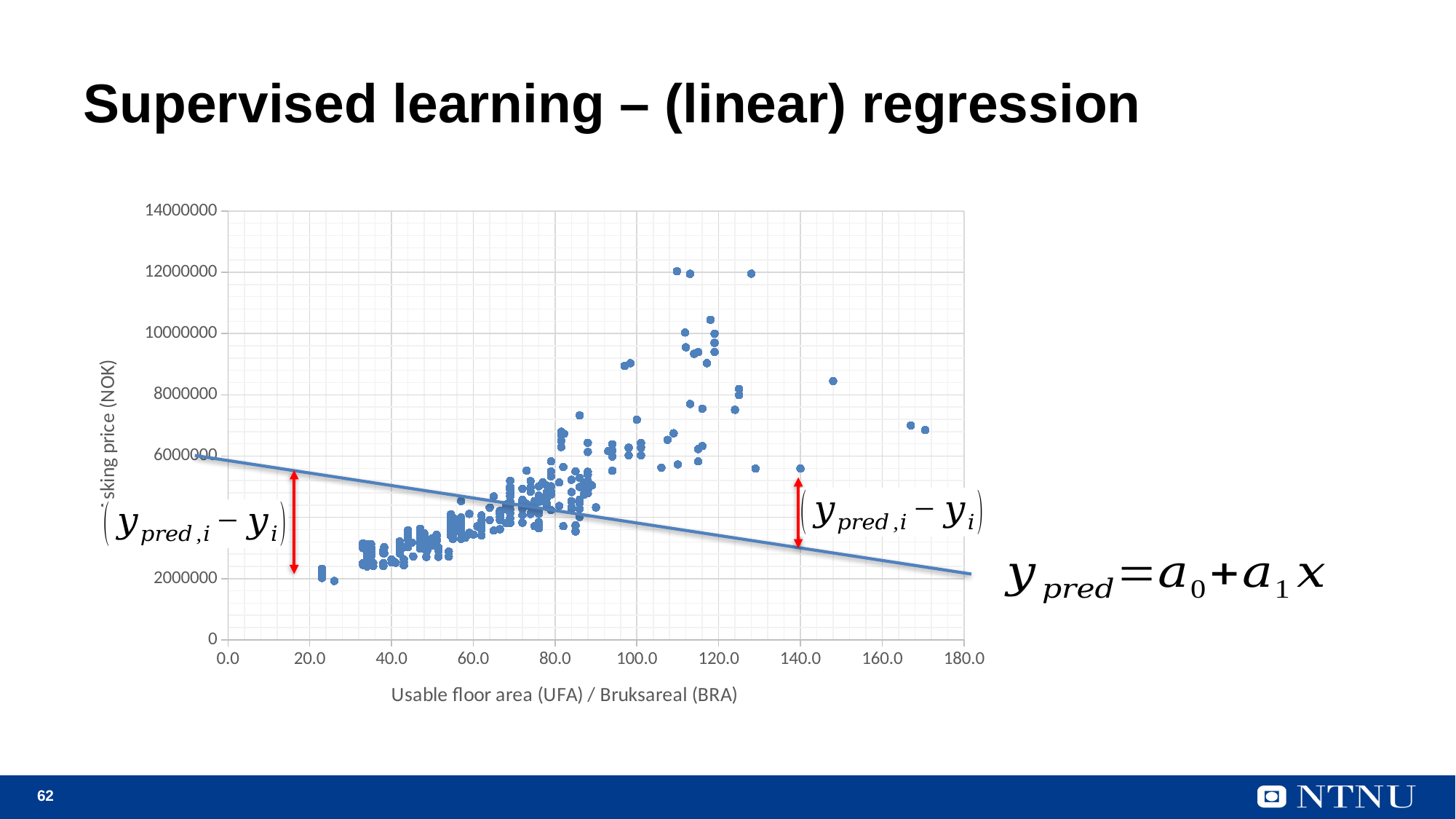
Do the plotted points generally rise or fall as usable floor area increases? rise Is the lowest plotted point in the chart greater or less than 4000000? less What is the title of the x axis of the chart? Usable floor area (UFA) / Bruksareal (BRA) What is the highest value shown on the y axis of the chart? 14000000 Is the value of the isolated point plotted near x = 148 greater or less than 8000000? greater What kind of chart is shown on the slide? scatter chart Is the highest plotted point in the chart greater or less than 10000000? greater